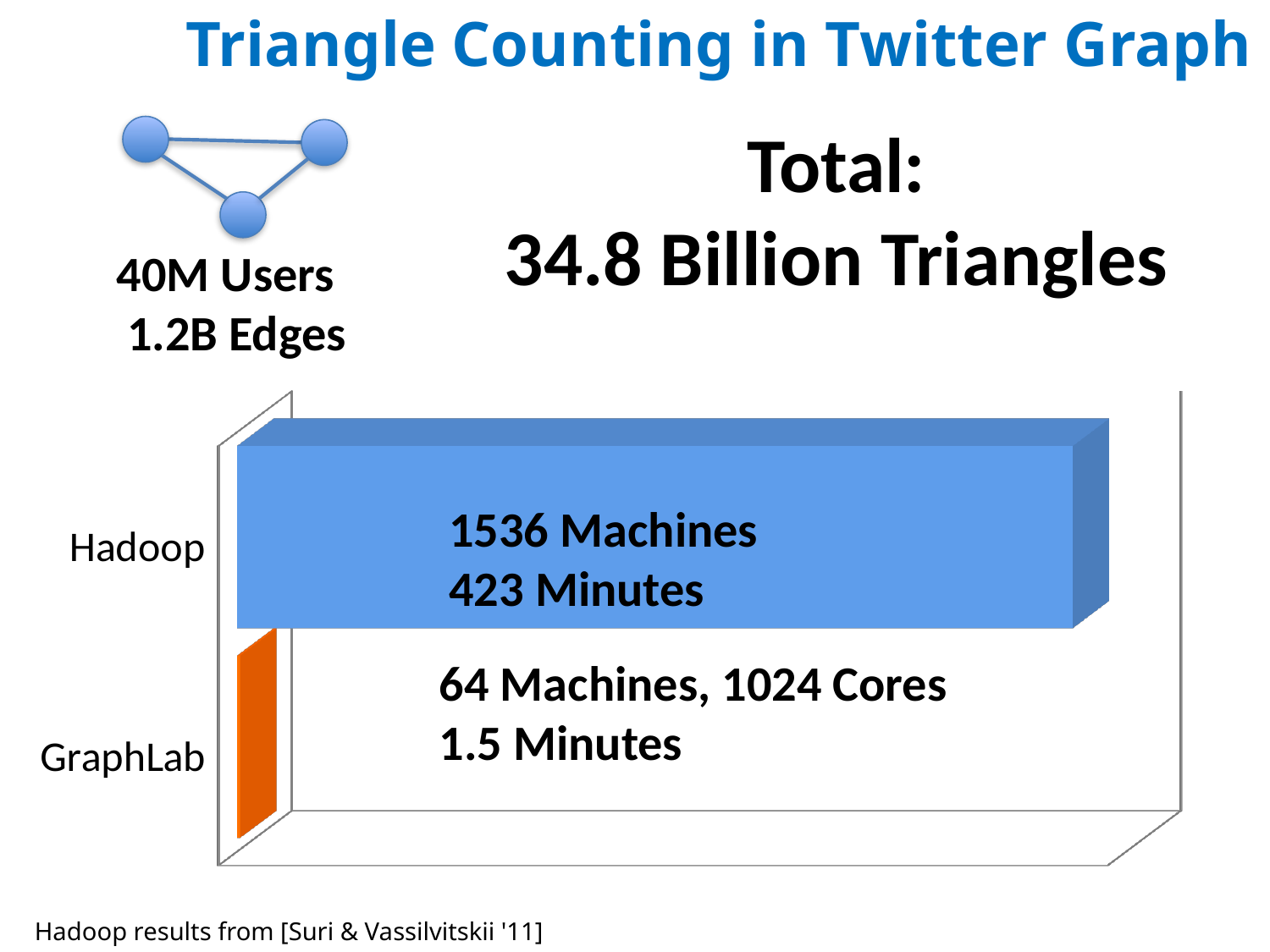
Which system has the shortest bar (fewest minutes)? GraphLab Which system has the longer bar (more minutes)? Hadoop How many minutes did GraphLab take for triangle counting? 1.5 Minutes How many cores did GraphLab use? 1024 Cores What is the difference in minutes between Hadoop and GraphLab? 421.5 Minutes How many machines did Hadoop use? 1536 Machines Which took more minutes, Hadoop or GraphLab? Hadoop How many systems are compared in the chart? 2 How many machines did GraphLab use? 64 Machines What colour is the GraphLab bar? Orange How many minutes did Hadoop take for triangle counting? 423 Minutes What kind of chart is shown on the slide? Bar chart